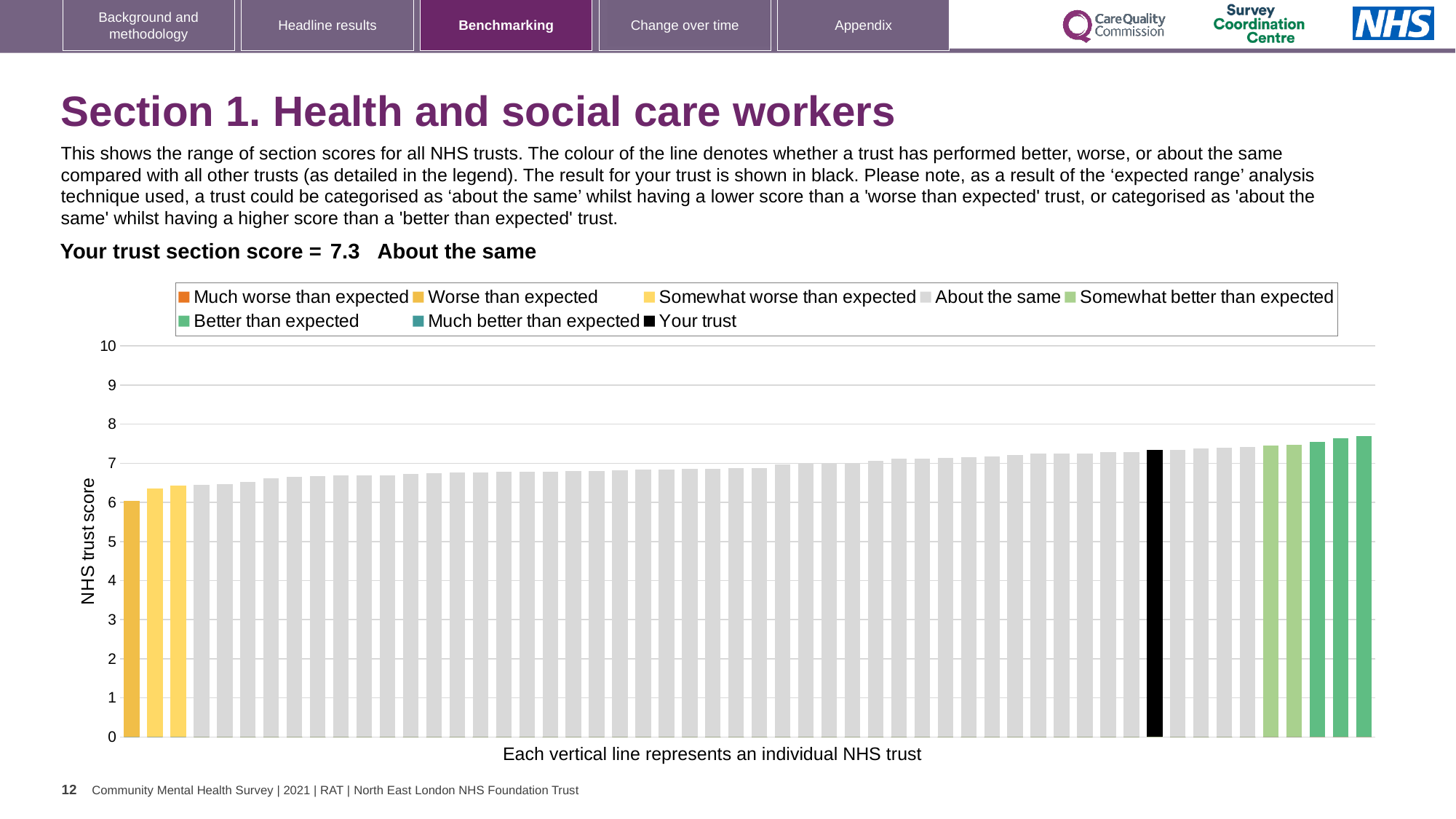
Is the value of the leftmost bar greater or less than 7? less What is the trust's section score for Section 1, Health and social care workers? 7.3 How many entries does the chart legend list? 8 Is the value of the black bar (your trust) greater or less than 7? greater How many bars are coloured yellow (somewhat worse than expected)? 2 Which is higher, the black bar for your trust or the leftmost bar? the black bar What is the label on the vertical axis of the chart? NHS trust score How is the trust's section score categorised compared with other trusts? About the same Do the bar values rise or fall from left to right along the x axis? rise What type of chart is shown on the slide? bar chart Is the value of the rightmost bar greater or less than 7? greater